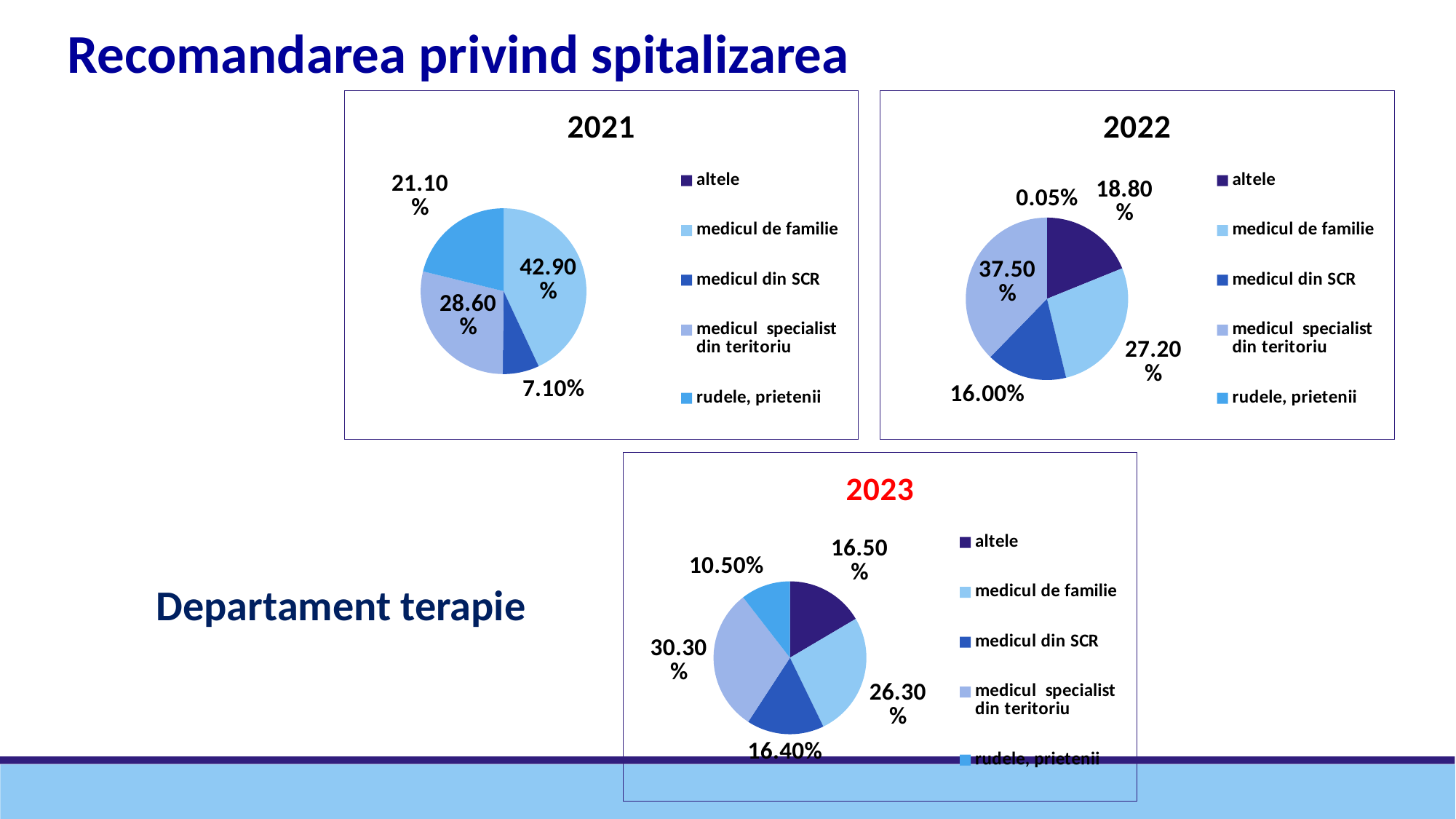
In the 2021 chart, which category has the largest share? medicul de familie In the 2022 chart, what is the value for medicul specialist din teritoriu? 37.50% In the 2021 chart, what is the value for medicul de familie? 42.90% In the 2022 chart, what is the difference between medicul specialist din teritoriu and medicul de familie? 10.30% In the 2023 chart, which category has the largest share? medicul specialist din teritoriu What kind of chart is the 2022 chart? pie chart In the 2023 chart, which is larger: altele or rudele, prietenii? altele How many series does the legend of the 2023 chart list? 5 What is the title of the chart at the bottom of the slide? 2023 In the 2023 chart, what is the value for rudele, prietenii? 10.50% In the 2022 chart, which category has the smallest share? rudele, prietenii In the 2021 chart, what is the value for medicul din SCR? 7.10%